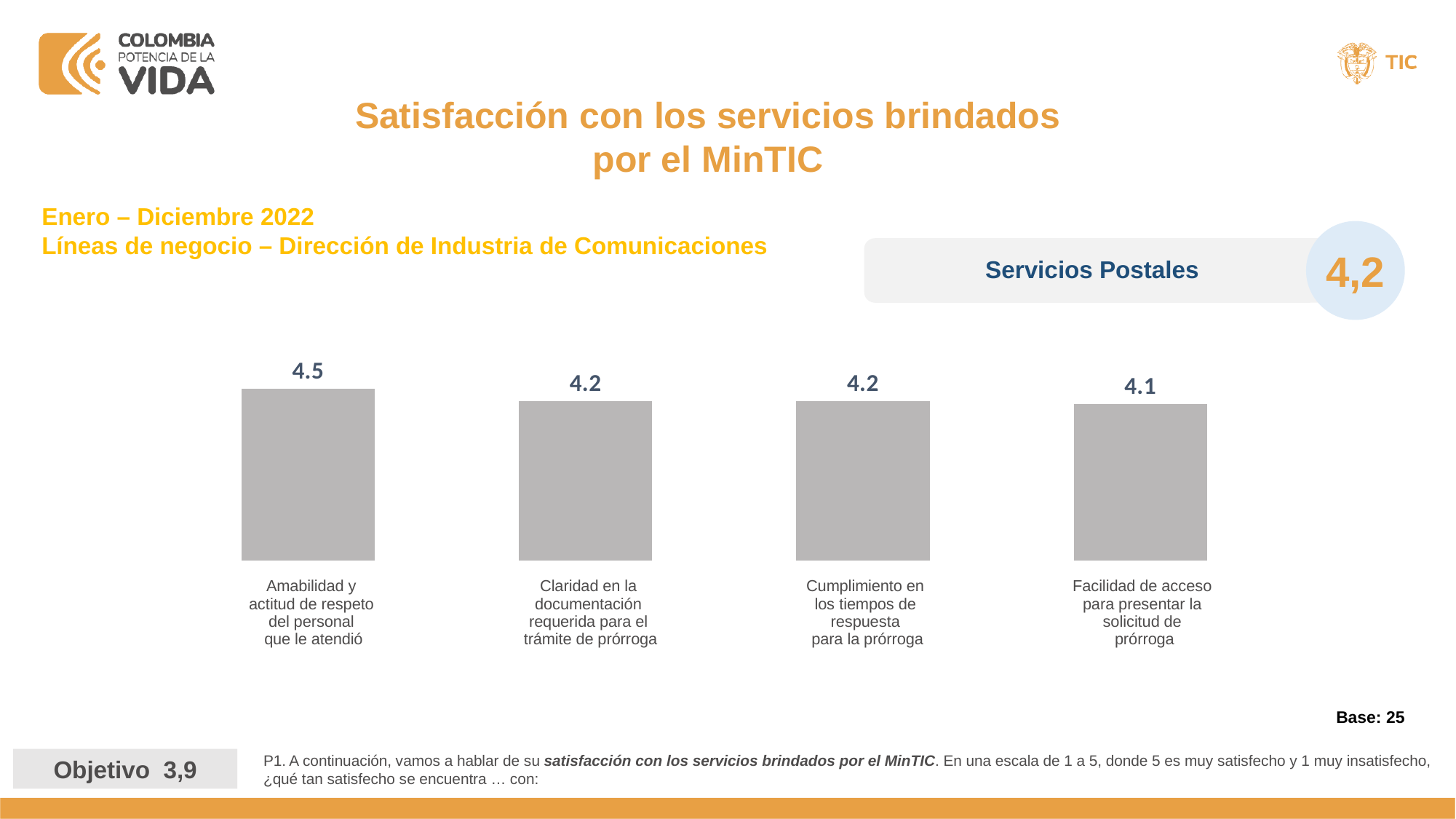
What overall score is shown for 'Servicios Postales' on the slide? 4,2 What kind of chart is shown on the slide? Bar chart What is the value for 'Cumplimiento en los tiempos de respuesta para la prórroga'? 4.2 What is the value for 'Facilidad de acceso para presentar la solicitud de prórroga'? 4.1 What is the difference between the value for 'Amabilidad y actitud de respeto del personal que le atendió' and the value for 'Facilidad de acceso para presentar la solicitud de prórroga'? 0.4 Do the values rise or fall from left to right across the chart? Fall What is the value for 'Amabilidad y actitud de respeto del personal que le atendió'? 4.5 How many categories are shown in the chart? 4 Which category has the highest value? Amabilidad y actitud de respeto del personal que le atendió What is the value for 'Claridad en la documentación requerida para el trámite de prórroga'? 4.2 Which is larger: the value for 'Amabilidad y actitud de respeto del personal que le atendió' or the value for 'Claridad en la documentación requerida para el trámite de prórroga'? Amabilidad y actitud de respeto del personal que le atendió Which category has the lowest value? Facilidad de acceso para presentar la solicitud de prórroga